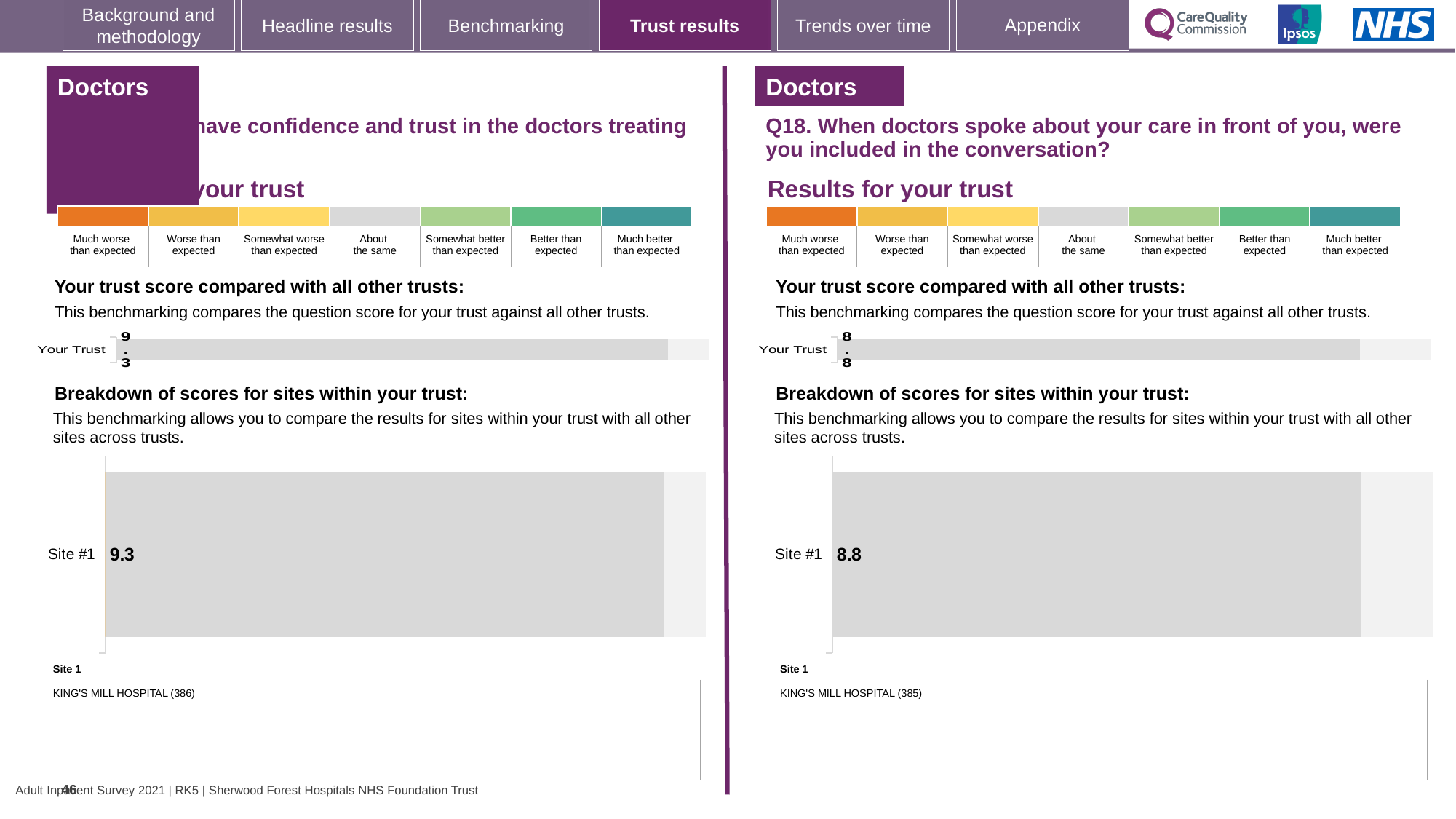
On the right half of the slide (Q18), is the Your Trust score greater or less than the Site #1 score, or are they equal? Equal How many sites are shown in the site breakdown chart on the right half of the slide (Q18)? 1 On the left half of the slide, which hospital is listed as Site 1? KING'S MILL HOSPITAL (386) On the right half of the slide (Q18), what score is shown for Your Trust? 8.8 On the right half of the slide (Q18), what score is shown for Site #1? 8.8 Which is larger: the Site #1 score on the left half of the slide or the Site #1 score on the right half (Q18)? Left half (9.3) What is the difference between the Your Trust score on the left half of the slide and the Your Trust score on the right half (Q18)? 0.5 How many sites are shown in the site breakdown chart on the left half of the slide? 1 On the right half of the slide (Q18), which hospital is listed as Site 1? KING'S MILL HOSPITAL (385) On the left half of the slide, what score is shown for Your Trust? 9.3 What type of chart is used to show the Site #1 score on the right half of the slide (Q18)? Bar chart On the left half of the slide, what score is shown for Site #1? 9.3